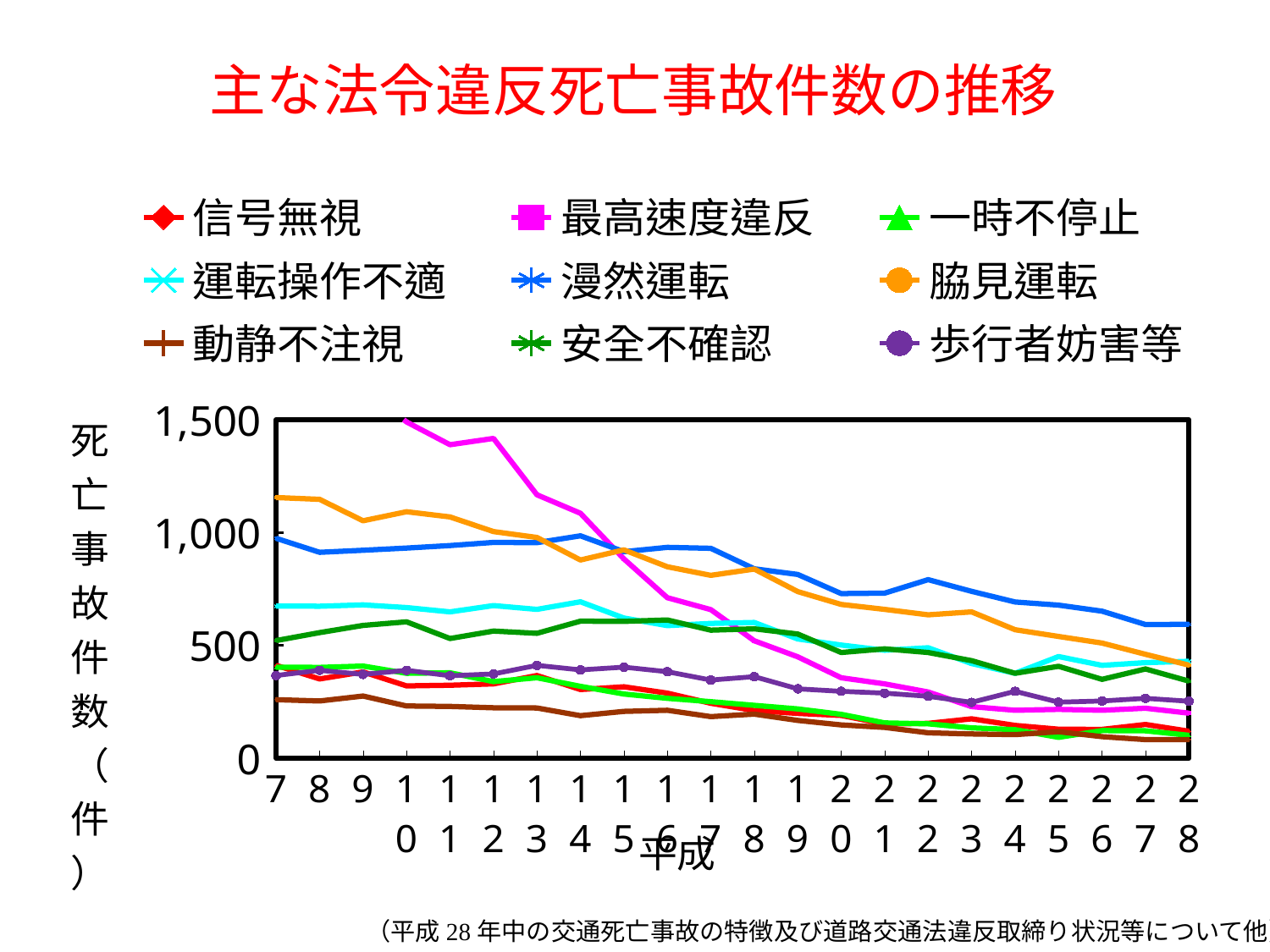
Is the value for 最高速度違反 in 平成12 greater or less than 1,000? greater How many series does the legend list? 9 How many years (x-axis points) are plotted on the chart? 22 Does the value for 最高速度違反 rise or fall from 平成10 to 平成28? fall Which series has the lowest value in 平成7? 動静不注視 What is the title of the chart? 主な法令違反死亡事故件数の推移 What kind of chart is shown on the slide? line chart Is the value for 脇見運転 in 平成7 greater or less than 1,000? greater Is the value for 歩行者妨害等 in 平成28 greater or less than 500? less In 平成28, which is larger: 漫然運転 or 脇見運転? 漫然運転 What is the label on the x axis of the chart? 平成